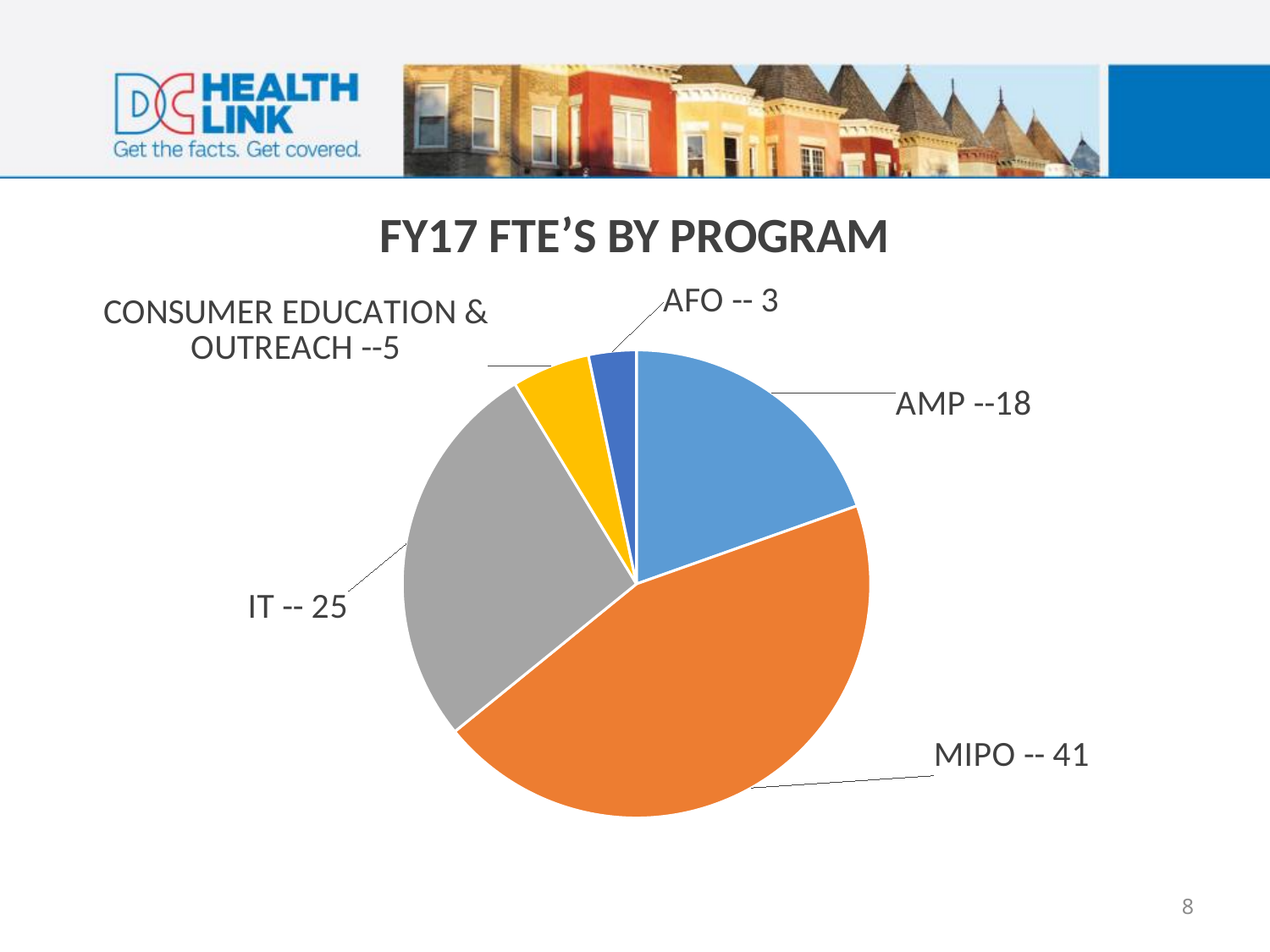
How many FTEs does the AMP program have? 18 How many FTEs does Consumer Education & Outreach have? 5 Which program has the smallest number of FTEs? AFO What kind of chart is shown on the slide? pie chart Which program has the largest number of FTEs? MIPO How many programs (slices) are shown in the pie chart? 5 What is the title of the chart? FY17 FTE'S BY PROGRAM How many FTEs does the IT program have? 25 What is the total number of FTEs across all programs in the chart? 92 What is the difference in FTEs between MIPO and IT? 16 How many FTEs does the MIPO program have? 41 Which has more FTEs, AMP or IT? IT